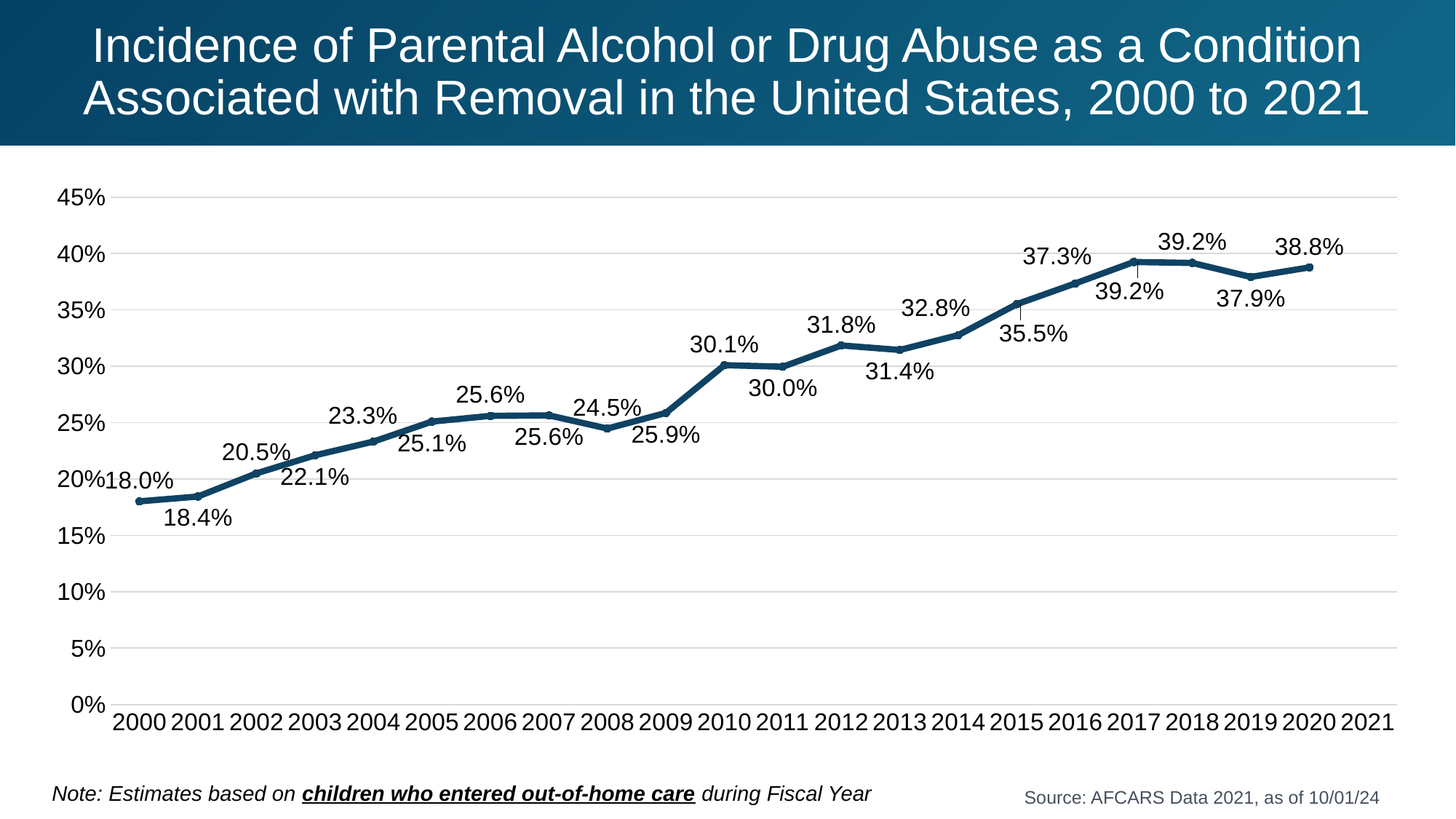
What is the value for 2000? 18.0% What is the difference between the values for 2020 and 2000? 20.8 percentage points What is the value for 2016? 37.3% Is the value for 2012 greater or less than 30%? greater What kind of chart is shown on the slide? Line chart Which is larger, the value for 2008 or the value for 2009? 2009 Which year has the lowest value? 2000 Do the values generally rise or fall from 2000 to 2020? Rise What is the difference between the values for 2017 and 2019? 1.3 percentage points What is the value for 2010? 30.1% What is the value for 2020? 38.8% What is the highest tick shown on the y axis? 45%